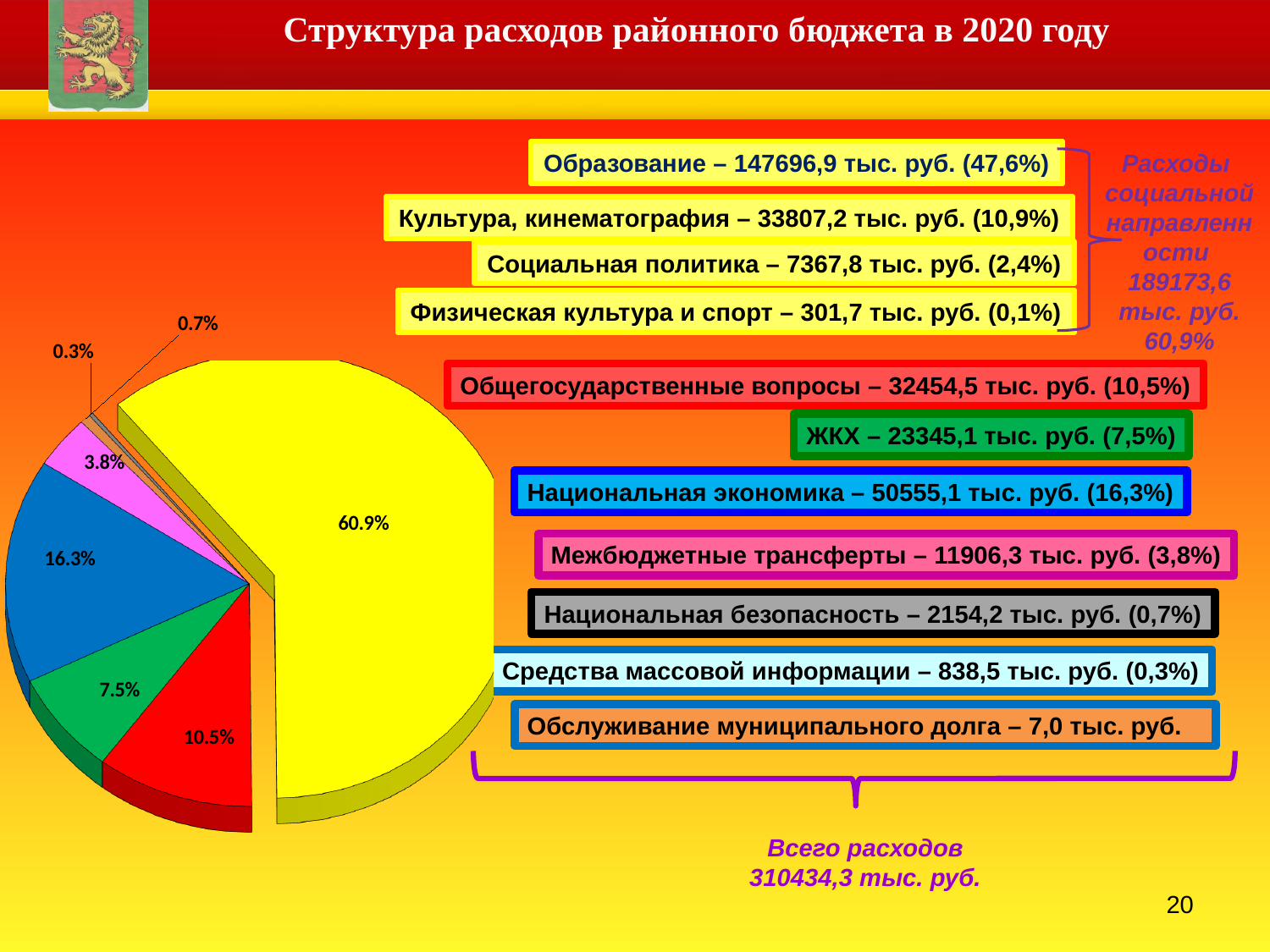
What is the title of the slide containing the pie chart? Структура расходов районного бюджета в 2020 году What percentage is shown on the largest slice of the pie chart? 60.9% What is the smallest percentage labelled on the pie chart? 0.3% Which is larger on the pie chart: the blue slice (16.3%) or the red slice (10.5%)? the blue slice (16.3%) What share of the pie does the pink slice (Межбюджетные трансферты) represent? 3.8% What kind of chart is shown on the slide? pie chart According to the slide, what is the total of all expenses (Всего расходов)? 310434,3 тыс. руб. According to the slide, what is the amount for Образование in thousand rubles? 147696,9 тыс. руб. What share of the pie does the green slice (ЖКХ) represent? 7.5% What is the difference in percentage points between the yellow slice (60.9%) and the blue slice (16.3%)? 44.6 What share of the pie does the red slice (Общегосударственные вопросы) represent? 10.5%